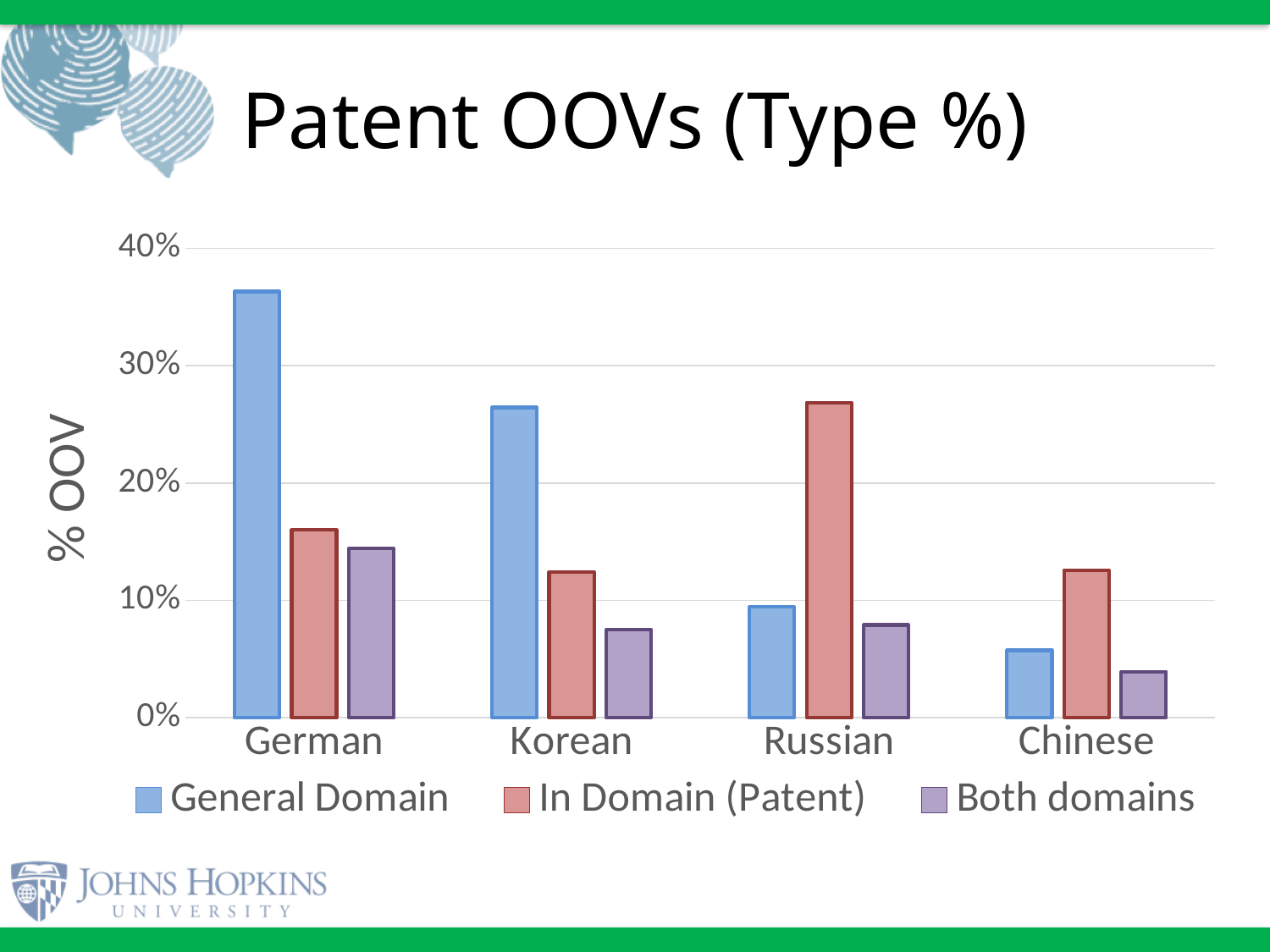
Is the In Domain (Patent) value for Russian greater or less than 20%? greater What kind of chart is shown on the slide? bar chart For German, which is larger: the General Domain value or the In Domain (Patent) value? General Domain Which language has the highest General Domain OOV value? German Is the General Domain value for German greater or less than 30%? greater How many series does the legend list? 3 For Russian, which is larger: the General Domain value or the In Domain (Patent) value? In Domain (Patent) Which language has the lowest Both domains OOV value? Chinese Is the Both domains value for Chinese greater or less than 10%? less How many languages are shown on the x axis of the chart? 4 Which language has the highest In Domain (Patent) OOV value? Russian What is the label on the y axis of the chart? % OOV